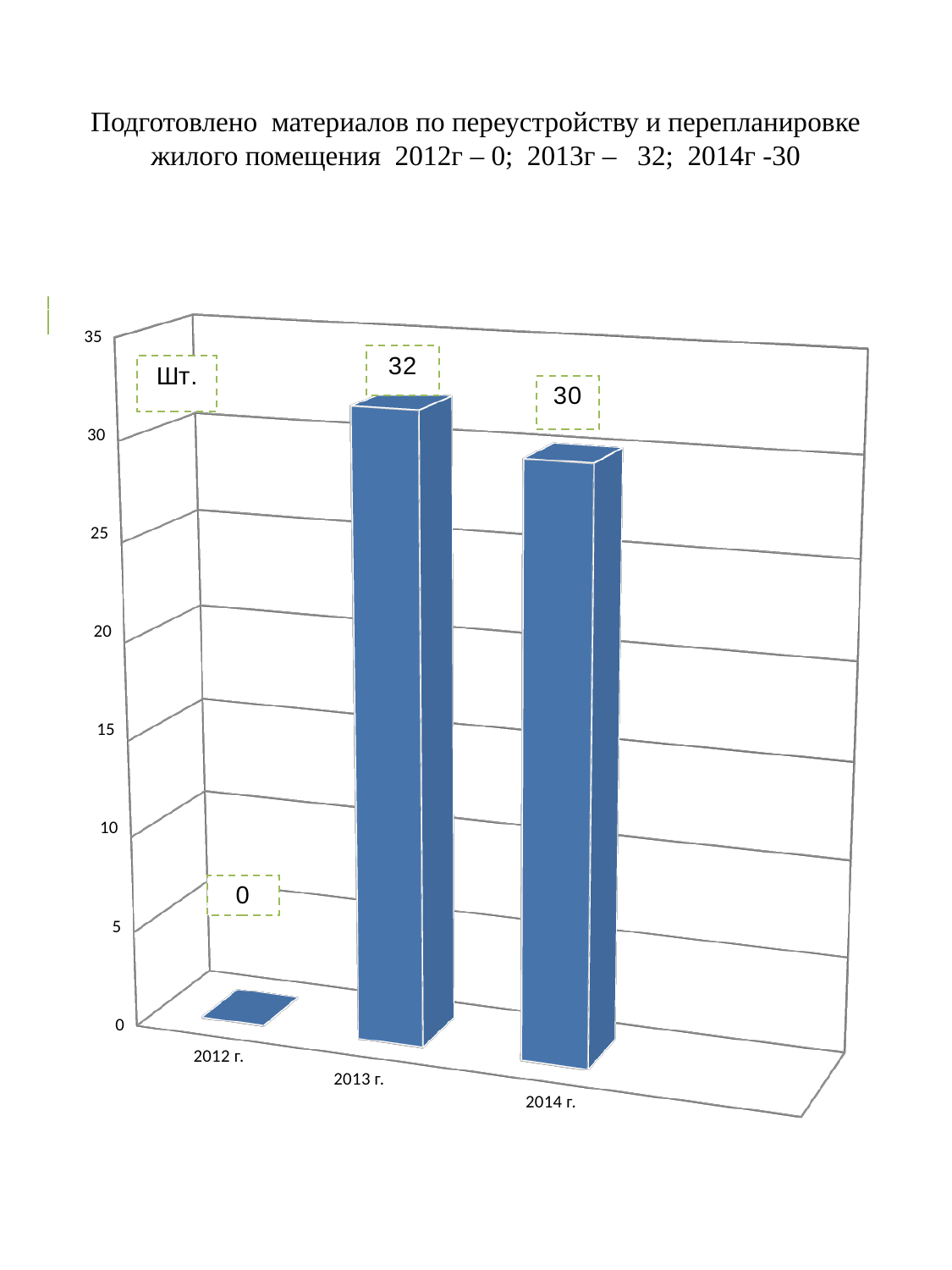
Is the value for 2014 г. greater or less than 25? greater What is the highest value shown on the vertical axis? 35 How many years are shown on the x axis? 3 What kind of chart is shown on the slide? bar chart What is the difference between the values for 2013 г. and 2014 г.? 2 Which year has the highest value? 2013 г. What is the value for 2013 г.? 32 Which year has the lowest value? 2012 г. What unit label is shown in the box at the top left of the chart? Шт. What is the value for 2012 г.? 0 Which is larger, the value for 2013 г. or the value for 2014 г.? 2013 г. What is the value for 2014 г.? 30